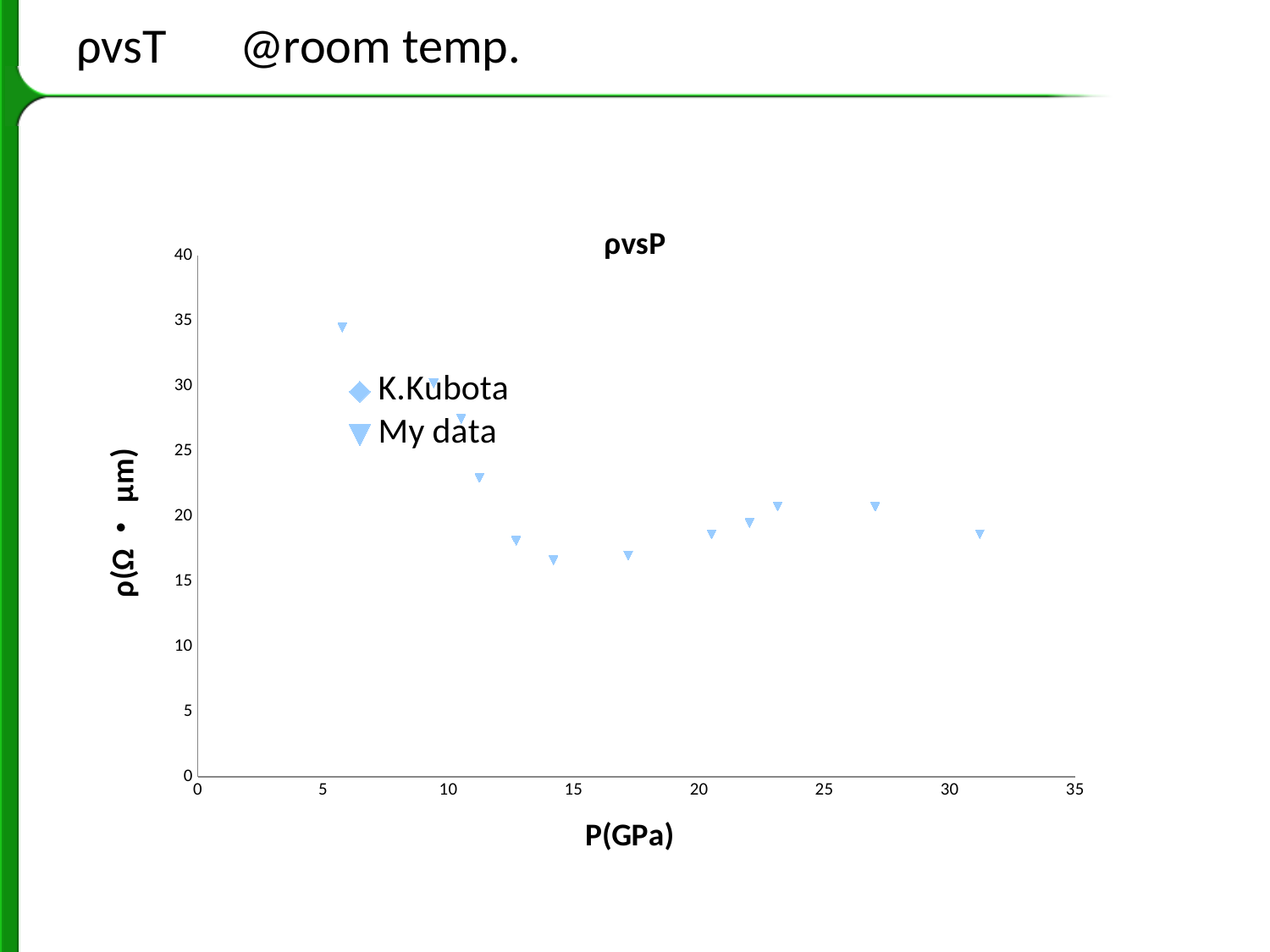
Which My data point has the larger ρ value: the one near 11 GPa or the one near 17 GPa? the one near 11 GPa Do the My data values rise or fall as pressure increases from about 5 GPa to about 15 GPa? fall Which My data point has the highest ρ value: the one near 5 GPa or the one near 23 GPa? the one near 5 GPa What kind of chart is shown on the slide? scatter chart Is the value of ρ for the My data point near 14 GPa greater or less than 20? less What is the title of the chart? ρvsP Is the value of ρ for the My data point near 31 GPa greater or less than 15? greater What are the two series named in the legend? K.Kubota and My data Is the value of ρ for the My data point near 5 GPa greater or less than 30? greater How many series does the chart legend list? 2